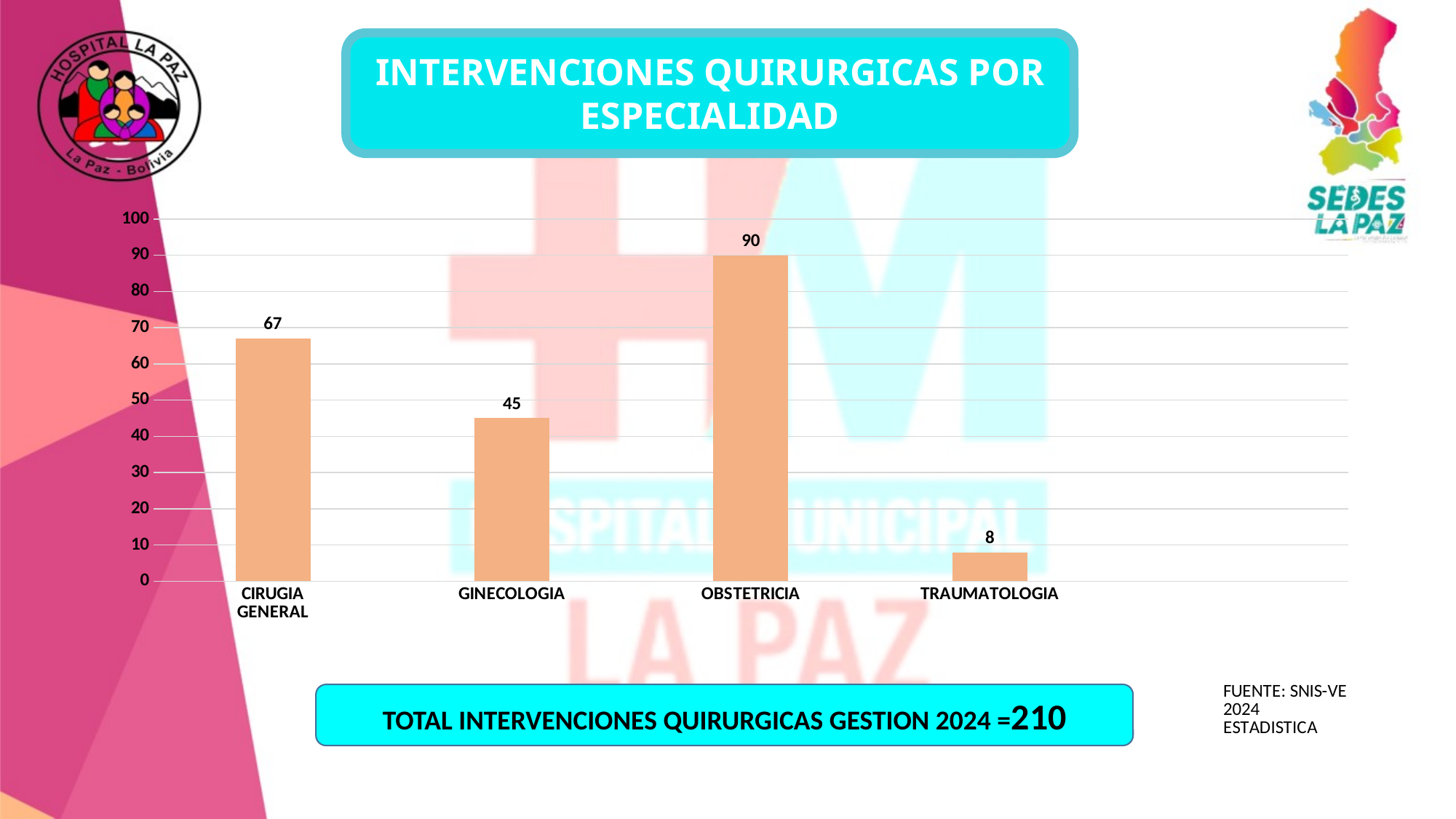
How many specialties are shown on the chart? 4 What is the difference between the values for OBSTETRICIA and CIRUGIA GENERAL? 23 What is the difference between the values for GINECOLOGIA and TRAUMATOLOGIA? 37 Which specialty has the lowest number of surgical interventions? TRAUMATOLOGIA What is the title of the chart? INTERVENCIONES QUIRURGICAS POR ESPECIALIDAD Which is larger, the value for CIRUGIA GENERAL or the value for GINECOLOGIA? CIRUGIA GENERAL What is the value for TRAUMATOLOGIA? 8 What is the value for OBSTETRICIA? 90 What kind of chart is shown on the slide? Bar chart Which specialty has the highest number of surgical interventions? OBSTETRICIA What is the value for CIRUGIA GENERAL? 67 What is the value for GINECOLOGIA? 45